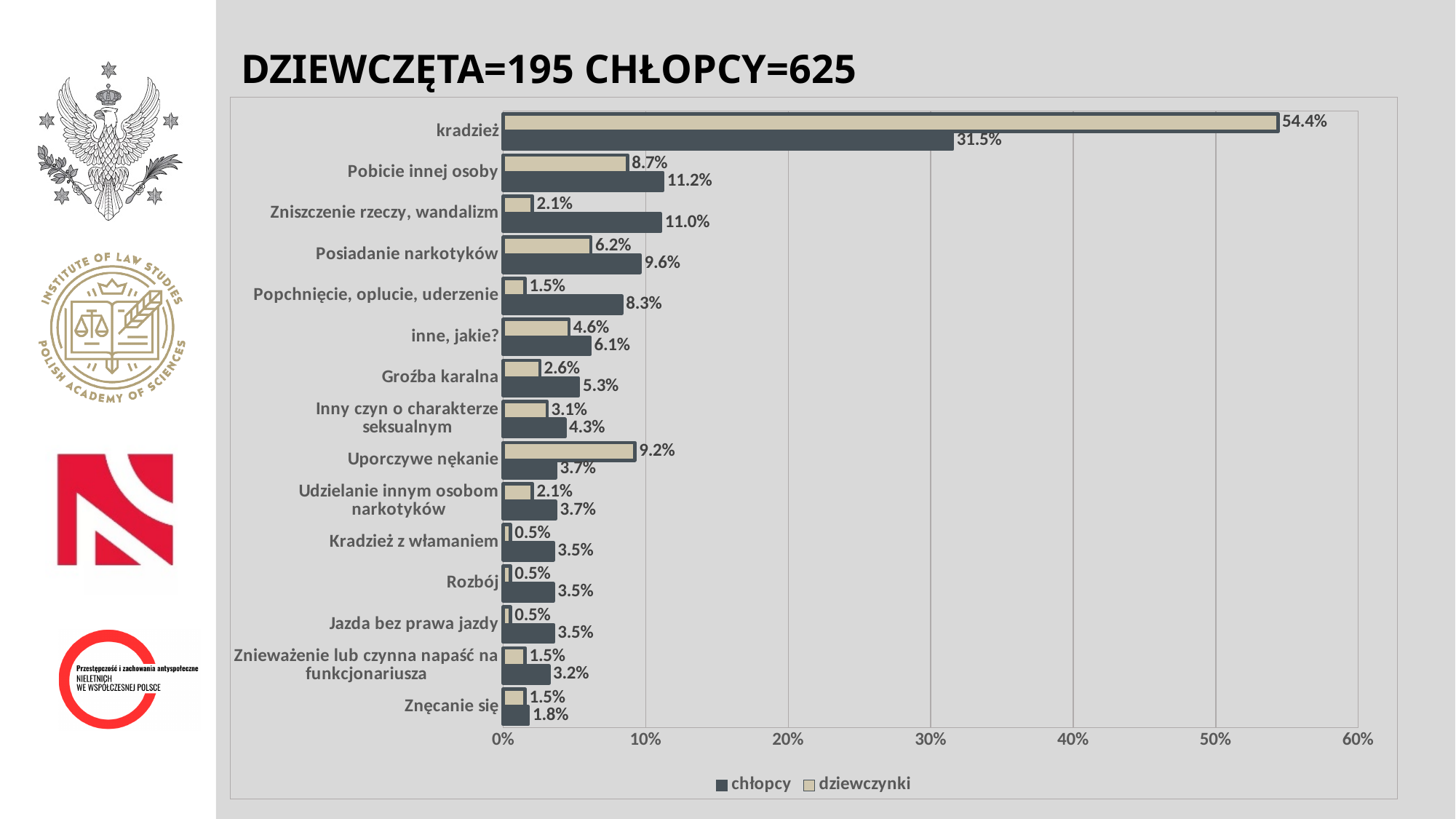
How many categories are shown on the chart? 15 Which is larger for Pobicie innej osoby: the chłopcy value or the dziewczynki value? chłopcy What is the value for dziewczynki for Uporczywe nękanie? 9.2% What is the value for chłopcy for Zniszczenie rzeczy, wandalizm? 11.0% Is the chłopcy value for kradzież greater or less than 30%? greater Which category has the highest value for chłopcy? kradzież What type of chart is shown on the slide? bar chart What is the difference between the dziewczynki and chłopcy values for kradzież? 22.9% What is the title of the chart? DZIEWCZĘTA=195 CHŁOPCY=625 Which category has the lowest value for chłopcy? Znęcanie się What is the value for dziewczynki for kradzież? 54.4% How many series does the legend list? 2